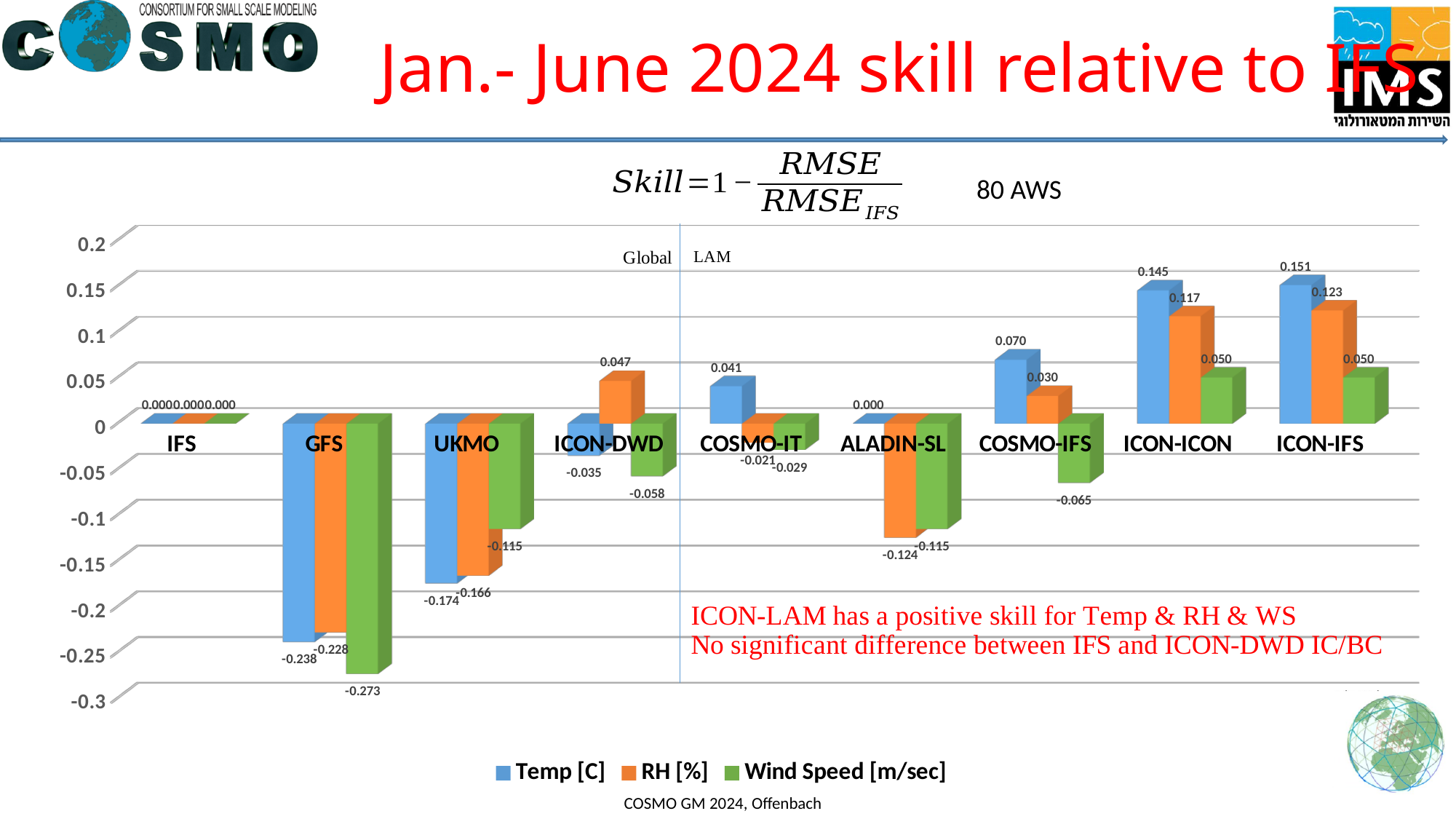
What is the RH [%] skill value for ICON-DWD? 0.047 What is the Wind Speed [m/sec] skill value for COSMO-IFS? -0.065 How many series does the legend list? 3 What is the difference between the Temp [C] skill values of ICON-IFS and ICON-ICON? 0.006 Which model has the lowest Wind Speed [m/sec] skill value? GFS How many models are shown on the x axis of the chart? 9 What is the RH [%] skill value for ALADIN-SL? -0.124 What is the Temp [C] skill value for GFS? -0.238 Which is larger, the RH [%] skill value for UKMO or for GFS? UKMO Which colour represents the Wind Speed [m/sec] series in the chart? Green What kind of chart is shown on the slide? Bar chart Which model has the highest Temp [C] skill value? ICON-IFS